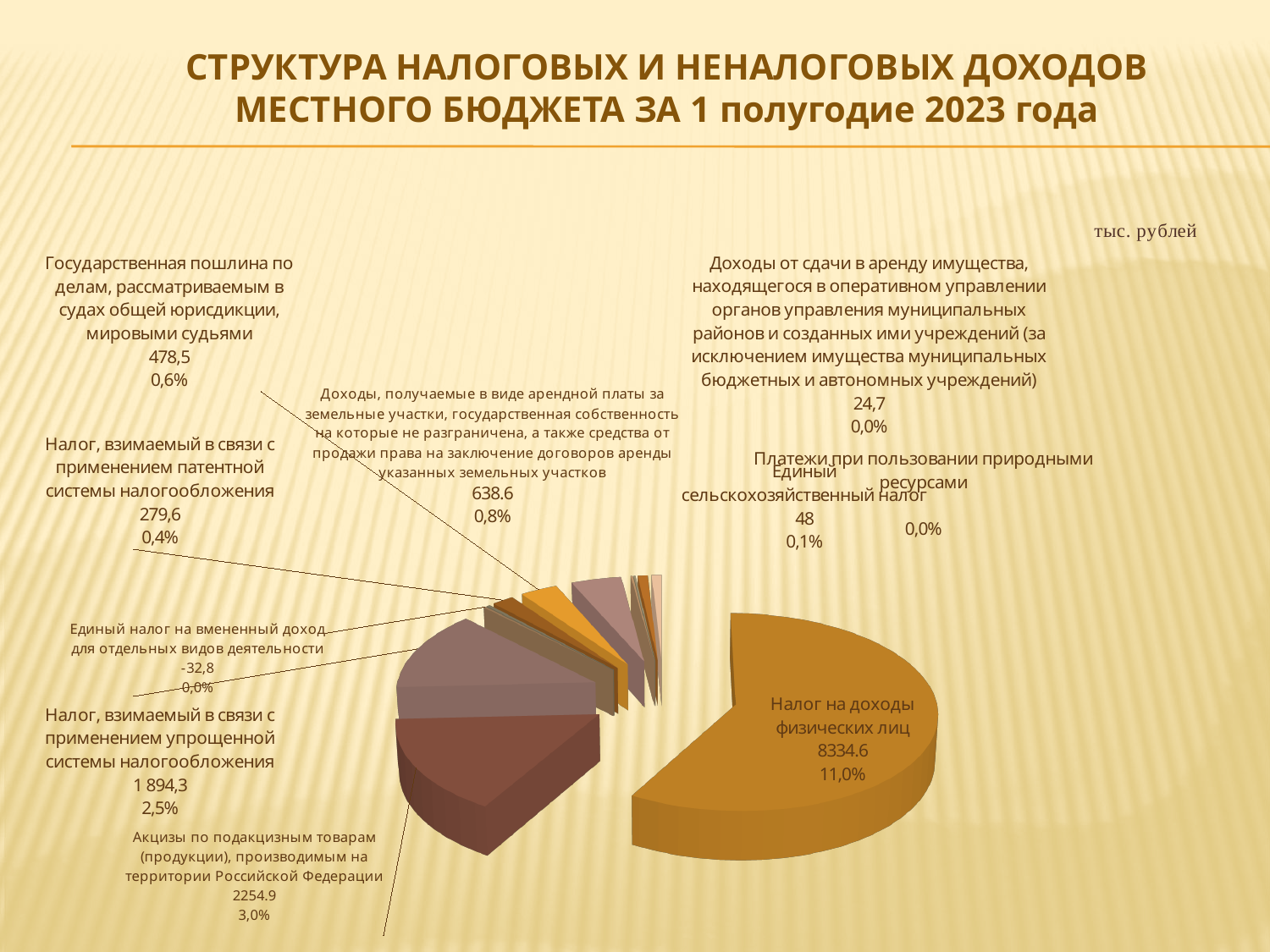
What is the value for Акцизы по подакцизным товарам (продукции), производимым на территории Российской Федерации? 2254.9 What is the value for Государственная пошлина по делам, рассматриваемым в судах общей юрисдикции, мировыми судьями? 478,5 What is the value for Налог на доходы физических лиц? 8334.6 In what units are the values on the chart given? тыс. рублей What percentage is shown for Доходы, получаемые в виде арендной платы за земельные участки? 0,8% What percentage is shown for Налог на доходы физических лиц? 11,0% Which category has the largest value? Налог на доходы физических лиц What is the value for Единый налог на вмененный доход для отдельных видов деятельности? -32,8 Which is larger: the value for Акцизы по подакцизным товарам or for Налог, взимаемый в связи с применением упрощенной системы налогообложения? Акцизы по подакцизным товарам What is the difference between the values for Налог на доходы физических лиц and Акцизы по подакцизным товарам? 6079.7 What is the value for Налог, взимаемый в связи с применением упрощенной системы налогообложения? 1 894,3 What kind of chart is shown on the slide? pie chart